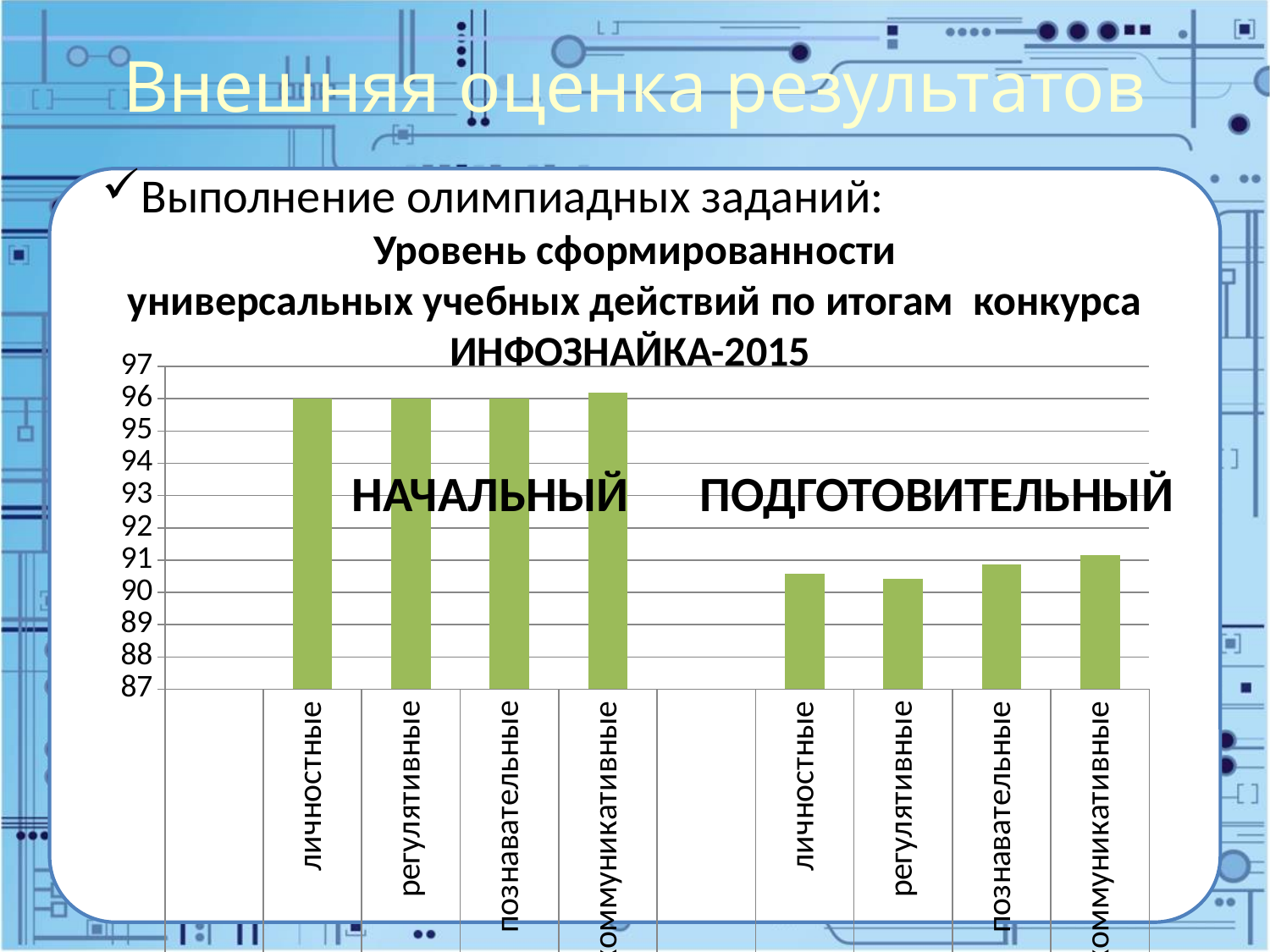
Which group has the higher values overall, НАЧАЛЬНЫЙ or ПОДГОТОВИТЕЛЬНЫЙ? НАЧАЛЬНЫЙ What are the two group labels printed inside the chart area? НАЧАЛЬНЫЙ and ПОДГОТОВИТЕЛЬНЫЙ Is the value for регулятивные in the ПОДГОТОВИТЕЛЬНЫЙ group greater or less than 92? less Which bar is the highest in the chart? коммуникативные (НАЧАЛЬНЫЙ) Is the value for личностные in the ПОДГОТОВИТЕЛЬНЫЙ group greater or less than 90? greater What is the lowest value shown on the vertical axis? 87 Is the value for познавательные in the НАЧАЛЬНЫЙ group greater or less than 95? greater How many bars are plotted in the chart? 8 What kind of chart is shown on the slide? bar chart What is the value for личностные in the НАЧАЛЬНЫЙ group? 96 Which is larger: коммуникативные in the НАЧАЛЬНЫЙ group or коммуникативные in the ПОДГОТОВИТЕЛЬНЫЙ group? коммуникативные in the НАЧАЛЬНЫЙ group